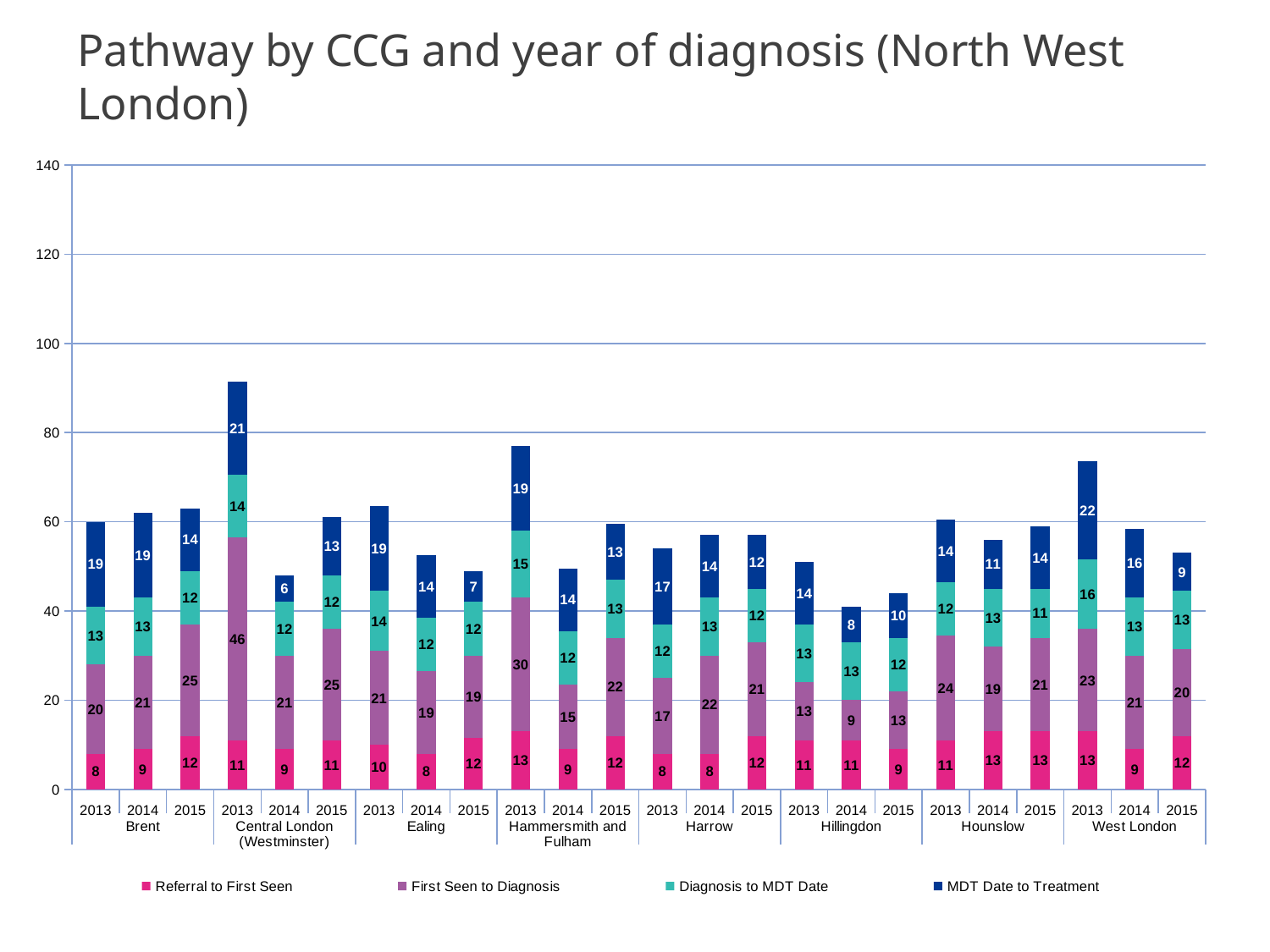
What is the difference between the MDT Date to Treatment values for Central London (Westminster) in 2013 and 2014? 15 What is the value of MDT Date to Treatment for West London in 2013? 22 What kind of chart is shown on the slide? Stacked bar chart What is the value of Referral to First Seen for Hammersmith and Fulham in 2013? 13 Which CCG and year has the tallest stacked bar overall? Central London (Westminster), 2013 Is the total stacked bar for Hammersmith and Fulham in 2013 greater or less than 60? greater How many series does the legend list? 4 What is the value of First Seen to Diagnosis for Central London (Westminster) in 2013? 46 What is the total of the stacked bar for Brent in 2013? 60 What is the total of the stacked bar for Hillingdon in 2014? 41 Which is larger: First Seen to Diagnosis for Hounslow in 2013 or for Hounslow in 2014? Hounslow 2013 Which CCG and year has the shortest stacked bar overall? Hillingdon, 2014